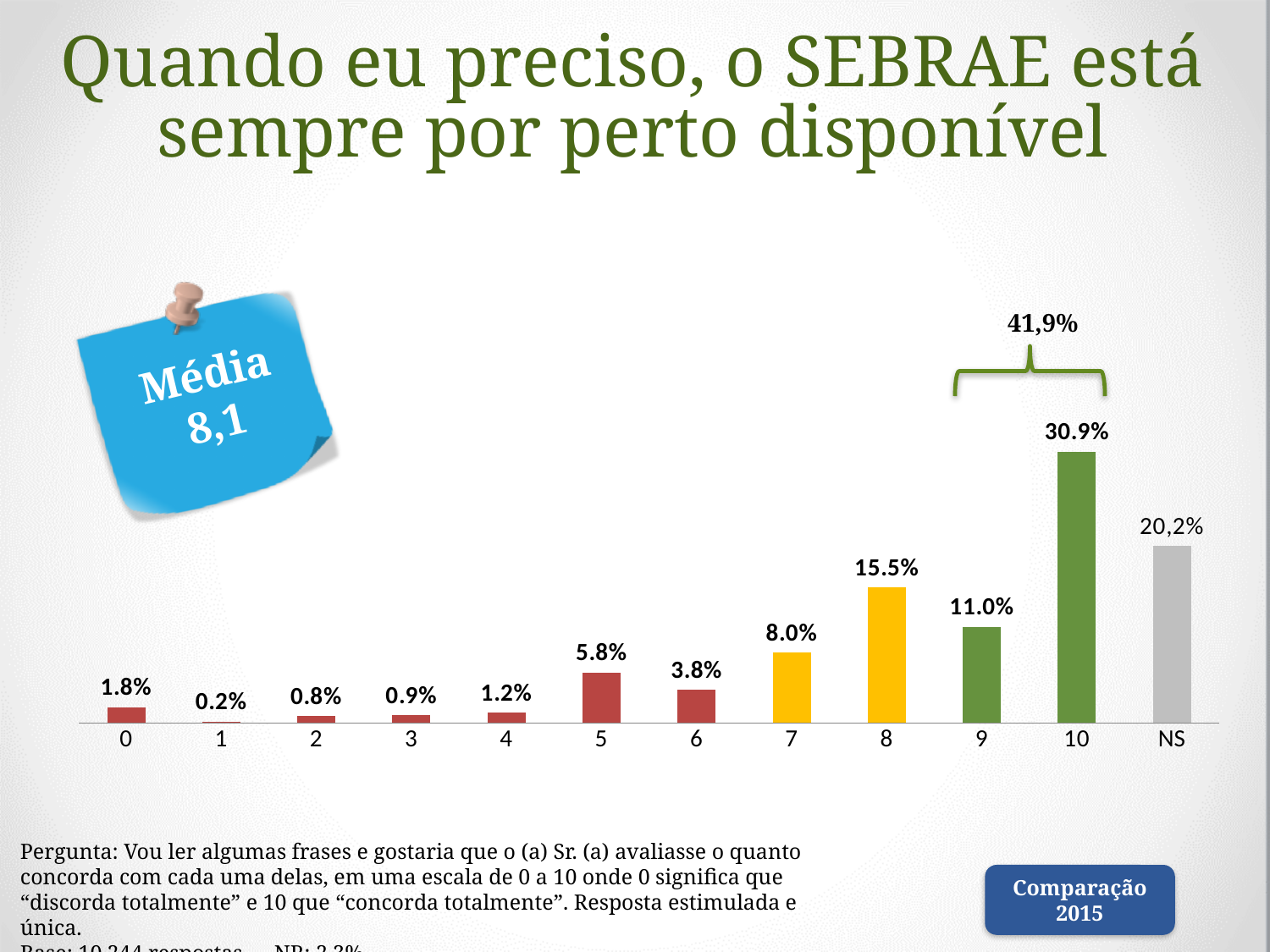
What combined value is shown by the bracket above categories 9 and 10? 41,9% What is the value for category 8? 15.5% How many categories are shown on the x axis? 12 Which category has the lowest value? 1 Which category has the highest value? 10 What average (Média) is shown on the sticky note? 8,1 What is the value for category 1? 0.2% What is the value for the NS category? 20,2% What kind of chart is shown on the slide? bar chart Which is larger, the value for category 5 or the value for category 6? 5 What is the value for category 10? 30.9% What is the difference between the values for category 10 and category 9? 19.9%